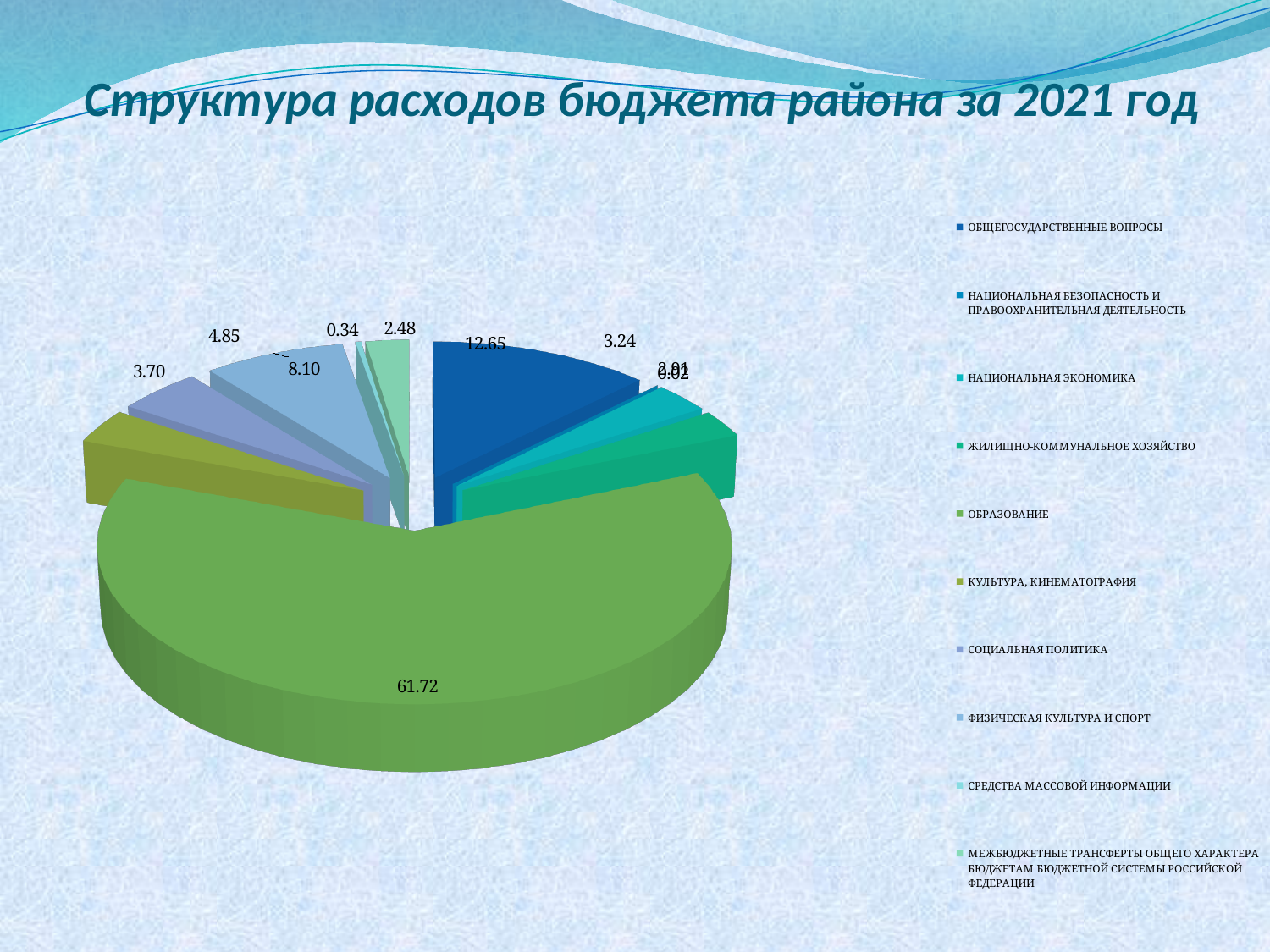
What is the largest value labelled on the pie chart? 61.72 What type of chart is shown on the slide? pie chart Which is larger: the slice for ОБРАЗОВАНИЕ or the slice for ОБЩЕГОСУДАРСТВЕННЫЕ ВОПРОСЫ? ОБРАЗОВАНИЕ What is the smallest value labelled on the pie chart? 0.02 Which category has the largest slice of the pie chart? ОБРАЗОВАНИЕ Which legend entry is listed first in the pie chart's legend? ОБЩЕГОСУДАРСТВЕННЫЕ ВОПРОСЫ How many categories does the legend of the pie chart list? 10 What value is shown for ОБРАЗОВАНИЕ in the pie chart? 61.72 What is the difference between the values for ОБРАЗОВАНИЕ and ОБЩЕГОСУДАРСТВЕННЫЕ ВОПРОСЫ? 49.07 What is the title of the chart on the slide? Структура расходов бюджета района за 2021 год Does the slice for ОБРАЗОВАНИЕ account for more or less than half of the pie? more What value is shown for ОБЩЕГОСУДАРСТВЕННЫЕ ВОПРОСЫ in the pie chart? 12.65